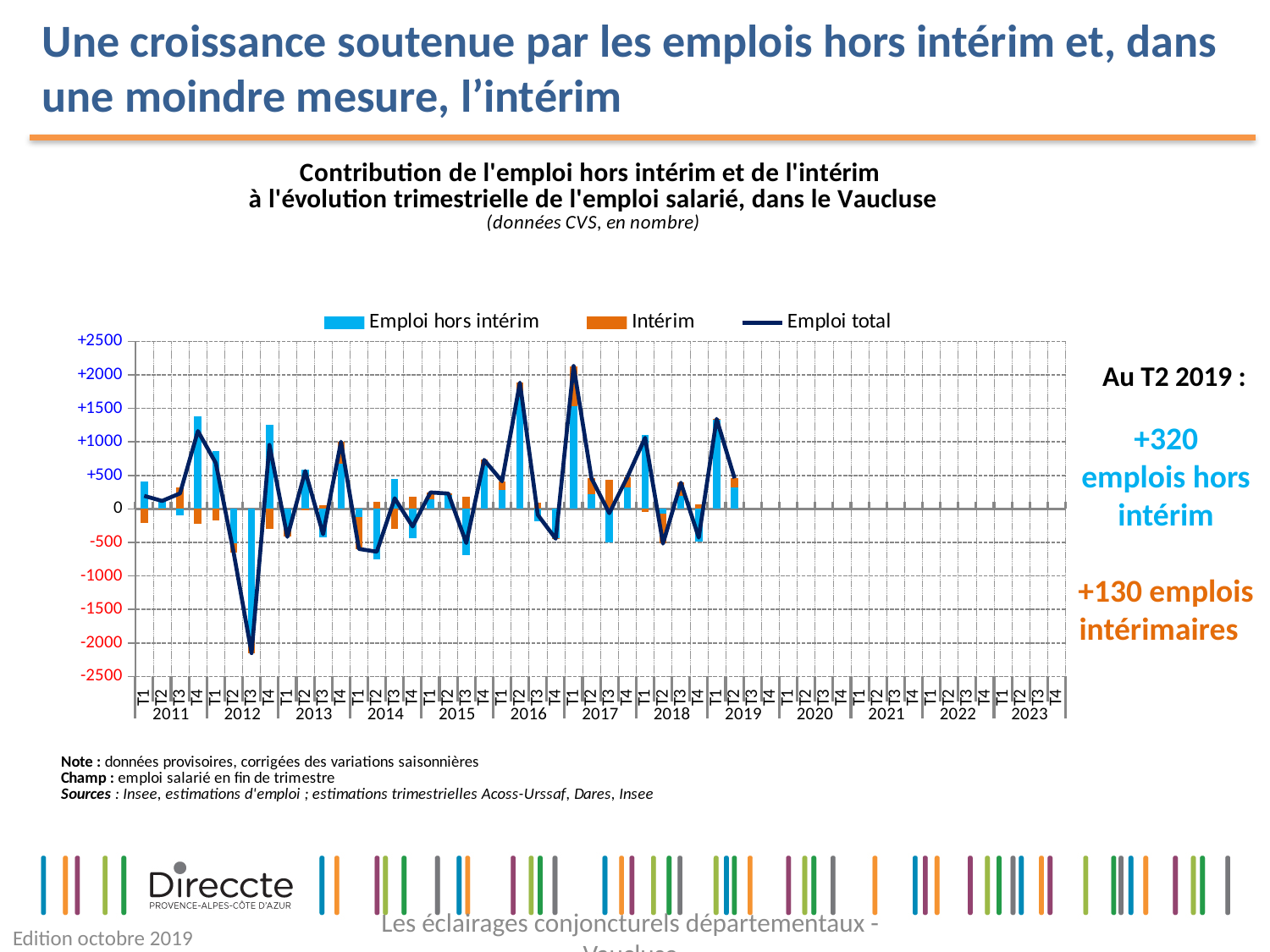
Is the value of 'Emploi total' at T3 2012 greater or less than -2000? less At T2 2019, what is the difference between the emplois hors intérim (+320) and the emplois intérimaires (+130)? 190 Which series is drawn as a dark navy line on the chart? Emploi total According to the annotation, what is the value for 'emplois hors intérim' at T2 2019? +320 How many series does the chart legend list? 3 Which series are listed in the chart legend? Emploi hors intérim, Intérim, Emploi total Is the value of 'Emploi total' at T1 2017 greater or less than +2000? greater In which quarter does the 'Emploi total' line reach its lowest point? T3 2012 At T2 2019, which is larger: the contribution of emplois hors intérim or of emplois intérimaires? Emplois hors intérim What kind of chart is shown on the slide? A combined bar and line chart In which quarter does the 'Emploi total' line reach its highest point? T1 2017 According to the annotation, what is the value for 'emplois intérimaires' at T2 2019? +130